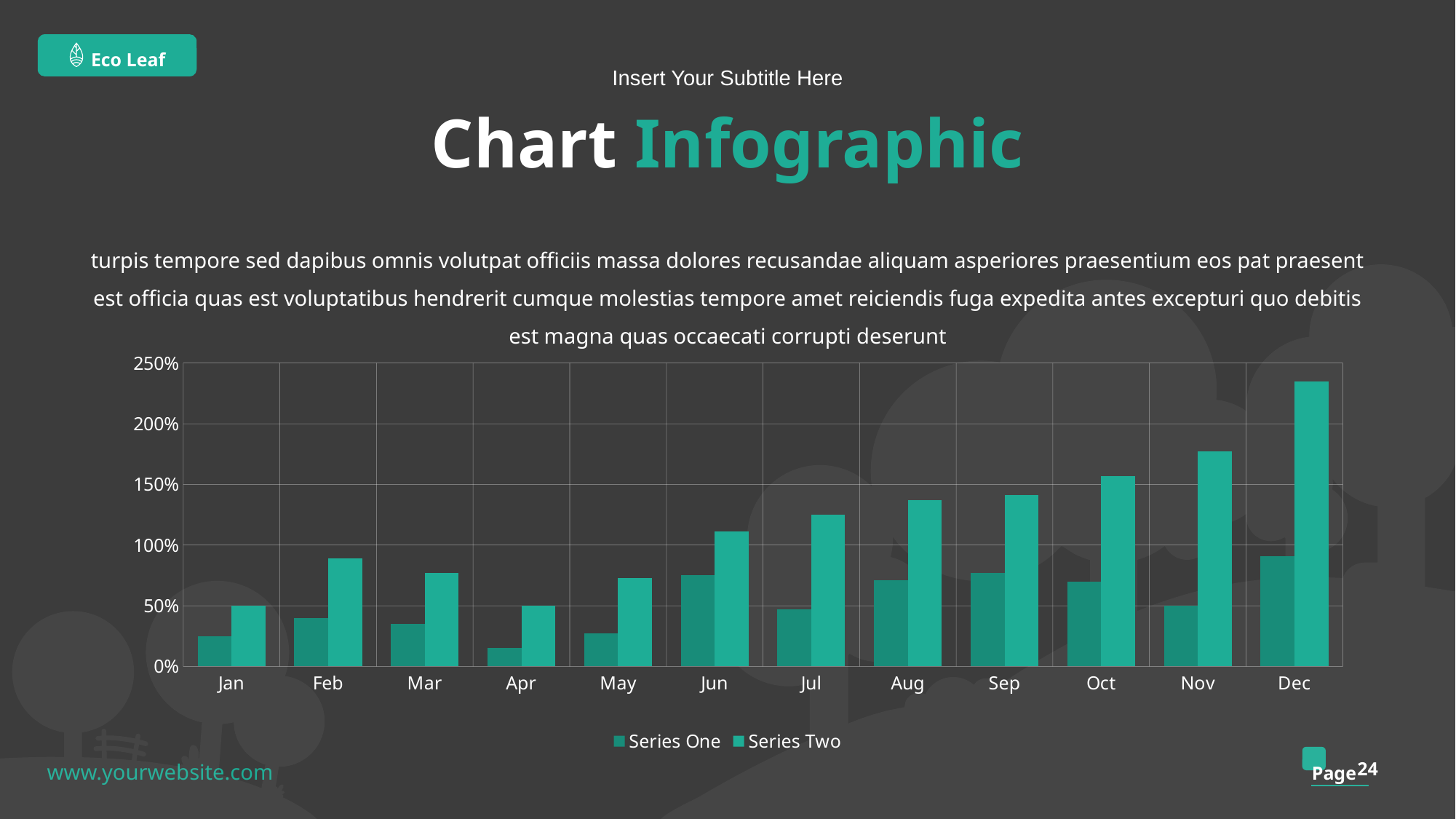
What kind of chart is shown on the slide? Bar chart In which month is the Series Two bar the highest? Dec Is the Series Two value for Dec greater or less than 200%? greater How many series does the chart legend list? 2 Is the Series One value for Jan greater or less than 50%? less In which month is the Series One bar the lowest? Apr What are the names of the series listed in the legend? Series One and Series Two Do the Series Two values rise or fall from Jun to Dec? Rise Is the Series Two value for Jun greater or less than 100%? greater How many months are shown on the x axis of the chart? 12 In Oct, which series has the larger value, Series One or Series Two? Series Two In which month is the Series One bar the highest? Dec